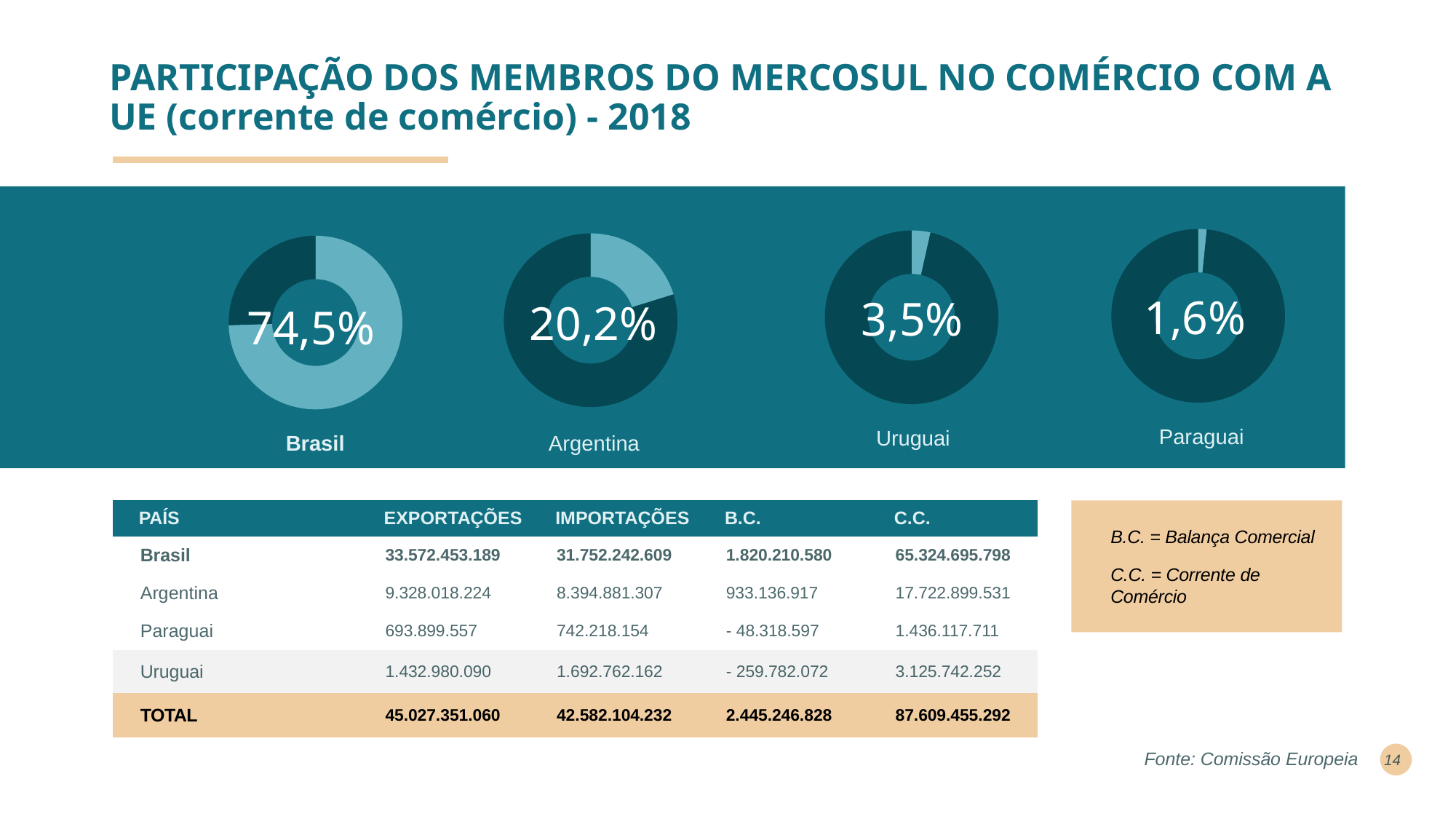
What kind of chart is used to show each country's share? Donut chart What is the difference between the shares shown in the Brasil and Argentina donut charts? 54,3% Which country's donut chart has its label in bold? Brasil What share does the Brasil donut chart show? 74,5% Which country's donut chart shows the highest share? Brasil What share does the Paraguai donut chart show? 1,6% Which country's donut chart shows the lowest share? Paraguai What share does the Uruguai donut chart show? 3,5% What share does the Argentina donut chart show? 20,2% Which is larger, the share shown for Argentina or the share shown for Uruguai? Argentina How many donut charts are shown on the slide? 4 What is the difference between the shares shown in the Uruguai and Paraguai donut charts? 1,9%